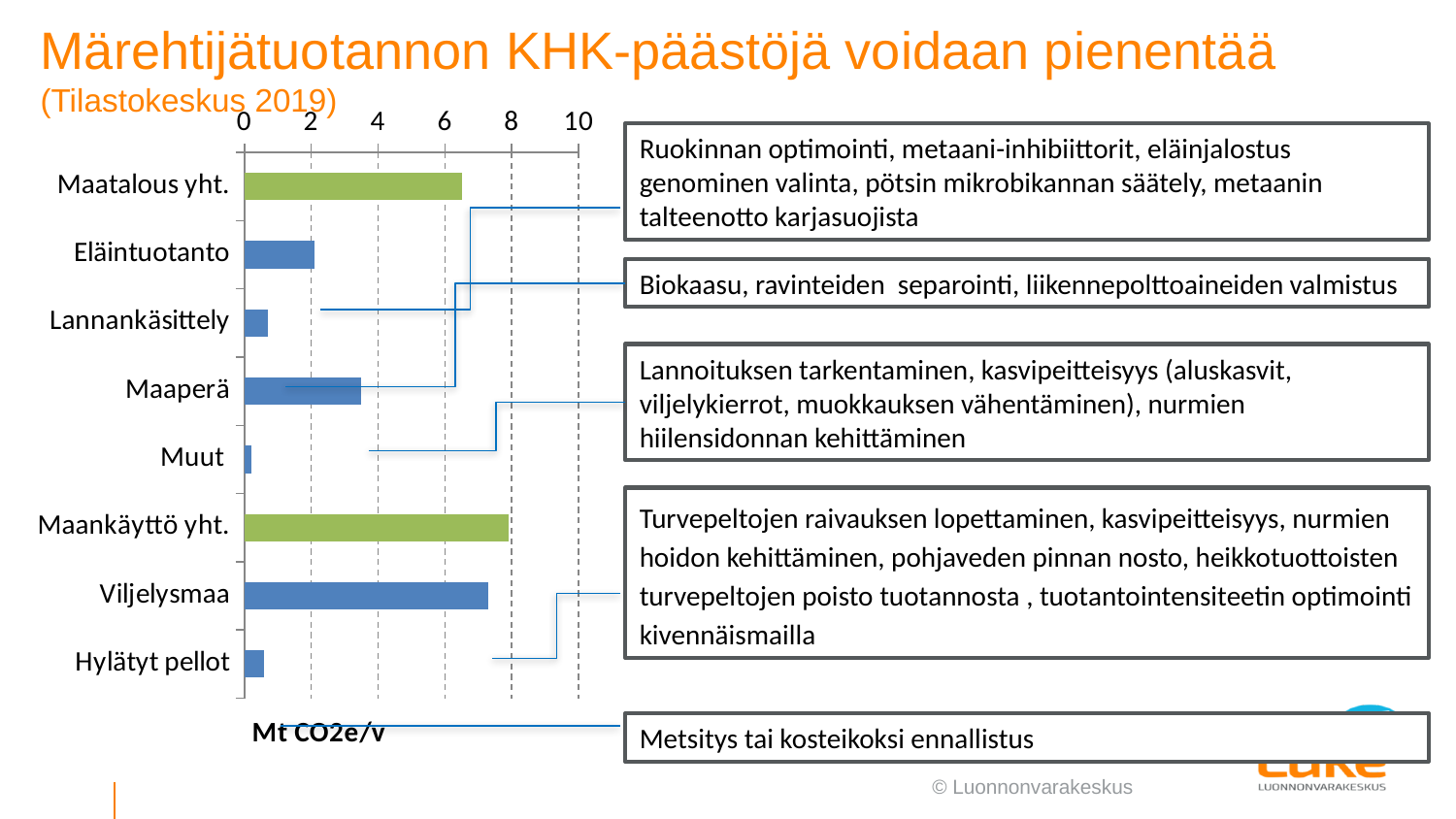
Which is larger, the value for Maankäyttö yht. or the value for Maatalous yht.? Maankäyttö yht. What kind of chart is shown on the slide? bar chart Is the value for Lannankäsittely greater or less than 2? less Which category has the highest value in the chart? Maankäyttö yht. Is the value for Viljelysmaa greater or less than 6? greater Is the value for Maaperä greater or less than 4? less How many categories are plotted in the chart? 8 What unit label is shown below the chart's axis? Mt CO2e/v Which category has the lowest value in the chart? Muut Which is larger, the value for Maaperä or the value for Eläintuotanto? Maaperä